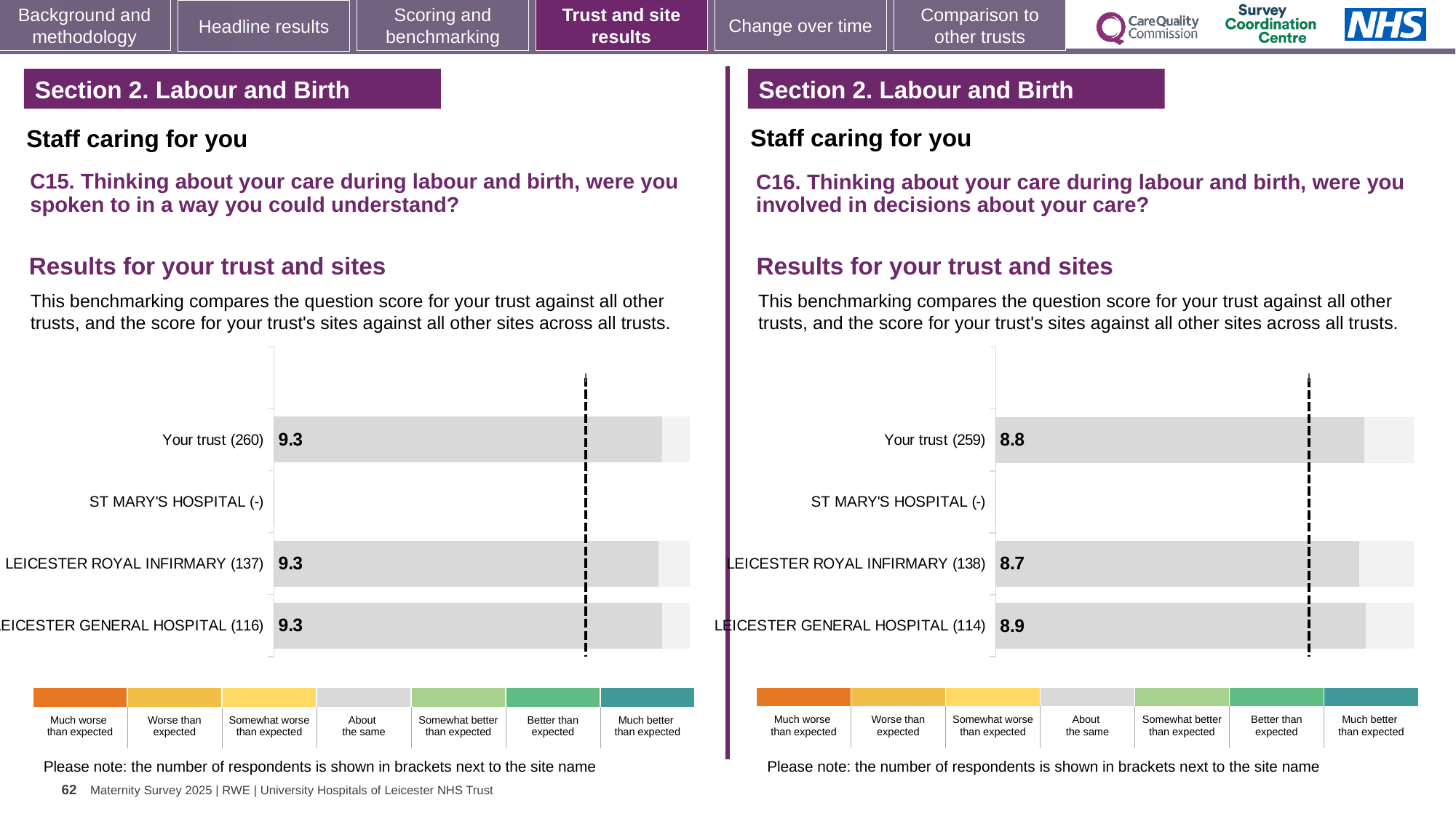
In the C15 chart on the left, which site has no bar shown? ST MARY'S HOSPITAL (-) In the C15 chart on the left, what is the score for Your trust (260)? 9.3 In the C16 chart on the right, which is larger: the score for Your trust (259) or for LEICESTER ROYAL INFIRMARY (138)? Your trust (259) How many categories does the colour legend below the C15 chart on the left list? 7 In the C16 chart on the right, which of the labelled bars has the lowest score? LEICESTER ROYAL INFIRMARY (138) What kind of chart is the C16 chart on the right? Bar chart How many categories are listed on the vertical axis of the C15 chart on the left? 4 In the C16 chart on the right, what is the difference between the scores for LEICESTER GENERAL HOSPITAL (114) and LEICESTER ROYAL INFIRMARY (138)? 0.2 In the C16 chart on the right, which site has the highest score? LEICESTER GENERAL HOSPITAL (114) In the C15 chart on the left, what is the score for LEICESTER ROYAL INFIRMARY (137)? 9.3 In the C16 chart on the right, what is the score for LEICESTER GENERAL HOSPITAL (114)? 8.9 In the C16 chart on the right, what is the score for Your trust (259)? 8.8